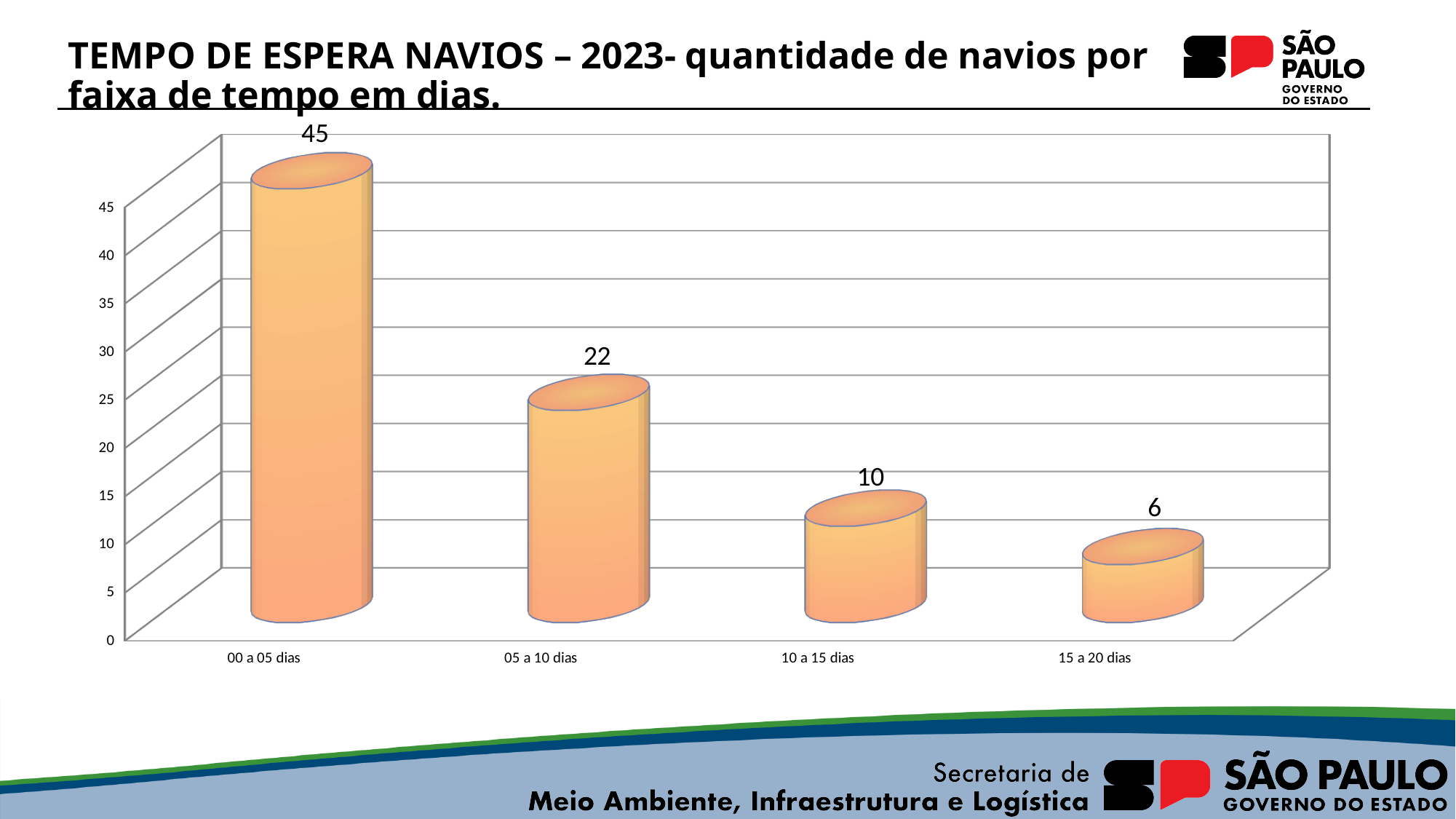
What is the value for '05 a 10 dias'? 22 What is the difference between the values for '10 a 15 dias' and '15 a 20 dias'? 4 What is the difference between the values for '00 a 05 dias' and '05 a 10 dias'? 23 Which is larger, the value for '05 a 10 dias' or the value for '10 a 15 dias'? 05 a 10 dias What is the value for '15 a 20 dias'? 6 How many time-range categories are shown on the chart? 4 Which time range has the lowest number of ships? 15 a 20 dias What kind of chart is shown on the slide? bar chart What is the value for '10 a 15 dias'? 10 Which time range has the highest number of ships? 00 a 05 dias Do the values rise or fall from left to right along the x axis? fall How many ships are shown for the '00 a 05 dias' category? 45